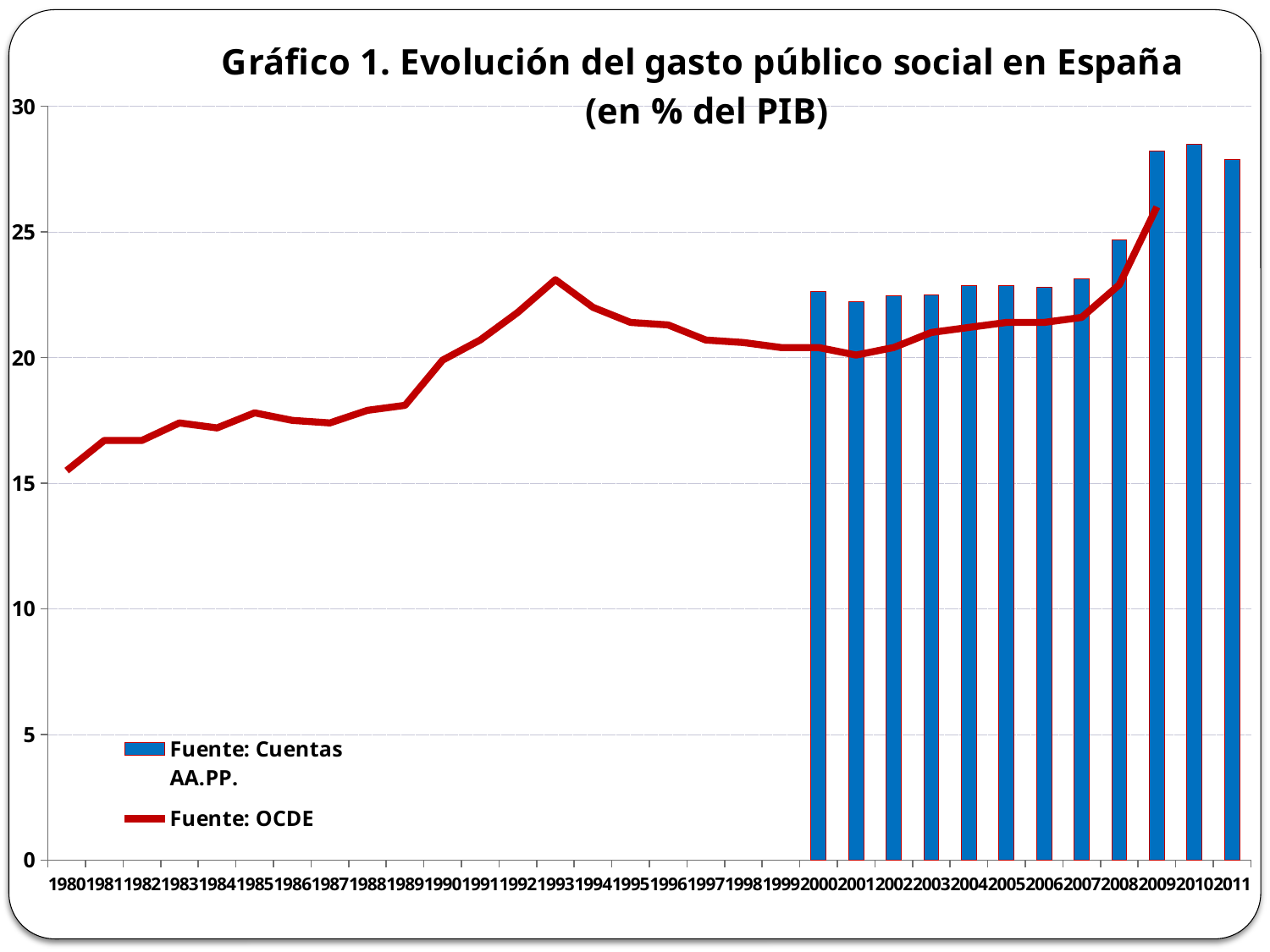
How many years are shown on the x axis? 32 In which year is the Fuente: Cuentas AA.PP. bar the lowest? 2001 Which is larger, the Fuente: Cuentas AA.PP. bar for 2010 or for 2011? 2010 What kind of chart is shown on the slide? A combined bar and line chart Is the Fuente: Cuentas AA.PP. value for 2010 greater or less than 25? greater What is the title of the chart? Gráfico 1. Evolución del gasto público social en España (en % del PIB) What are the two series named in the legend? Fuente: Cuentas AA.PP. and Fuente: OCDE How many bars does the Fuente: Cuentas AA.PP. series have? 12 How many series does the legend list? 2 Is the Fuente: OCDE value for 1993 greater or less than 20? greater In which year is the Fuente: Cuentas AA.PP. bar the highest? 2010 In which year does the Fuente: OCDE line reach its lowest value? 1980